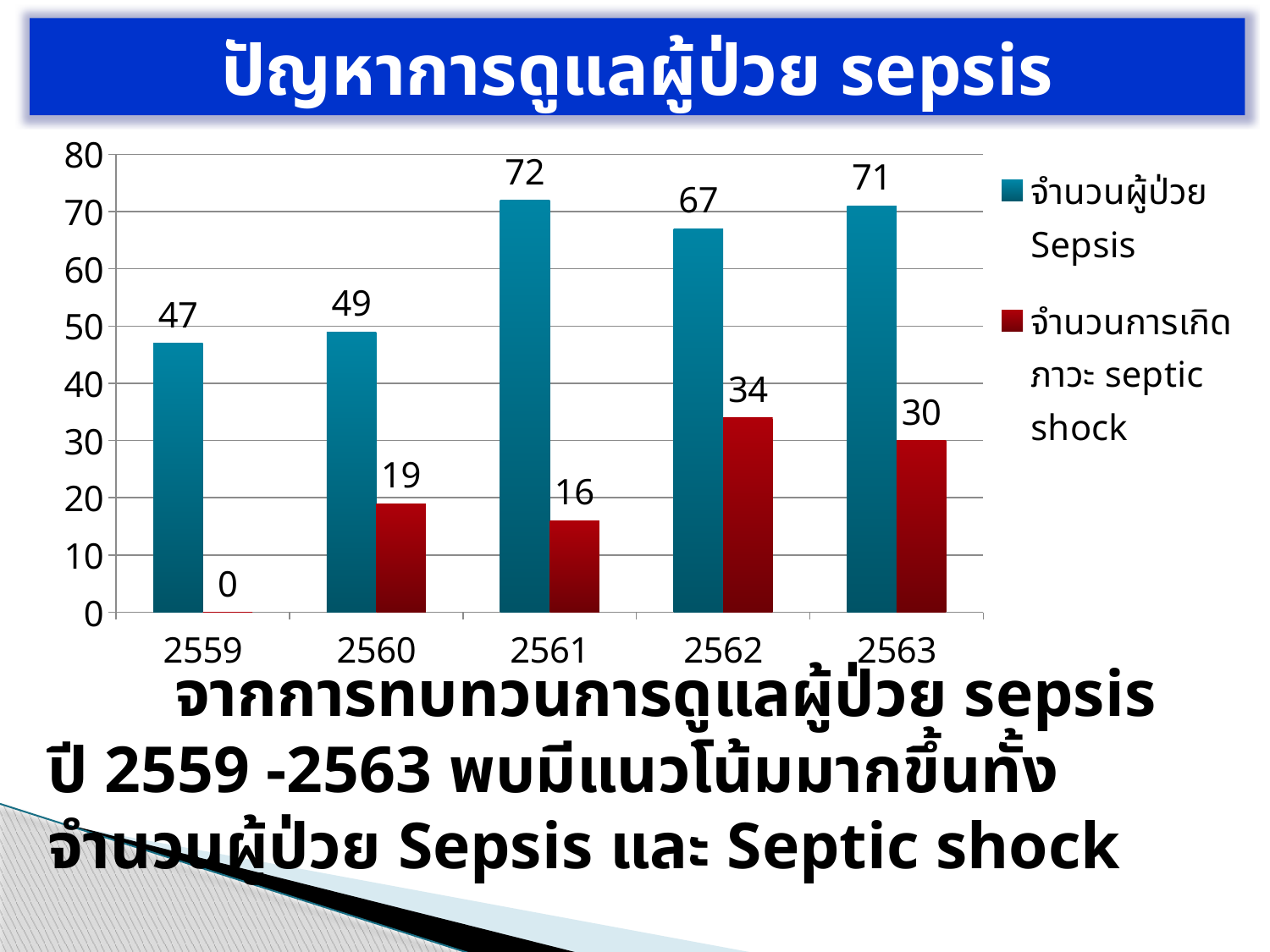
What is the difference between the number of Sepsis patients and the number of septic shock cases in 2563? 41 Which is larger: the number of septic shock cases in 2560 or in 2561? 2560 What is the number of septic shock cases in 2559? 0 What is the number of septic shock cases (จำนวนการเกิดภาวะ septic shock) in 2562? 34 How many series does the legend list? 2 Which colour represents the septic shock series (จำนวนการเกิดภาวะ septic shock) in the chart? dark red Is the number of Sepsis patients in 2562 greater or less than 60? greater What is the number of Sepsis patients (จำนวนผู้ป่วย Sepsis) in 2561? 72 What type of chart is shown on the slide? bar chart How many years are shown on the x axis? 5 In which year is the number of Sepsis patients highest? 2561 In which year is the number of Sepsis patients lowest? 2559